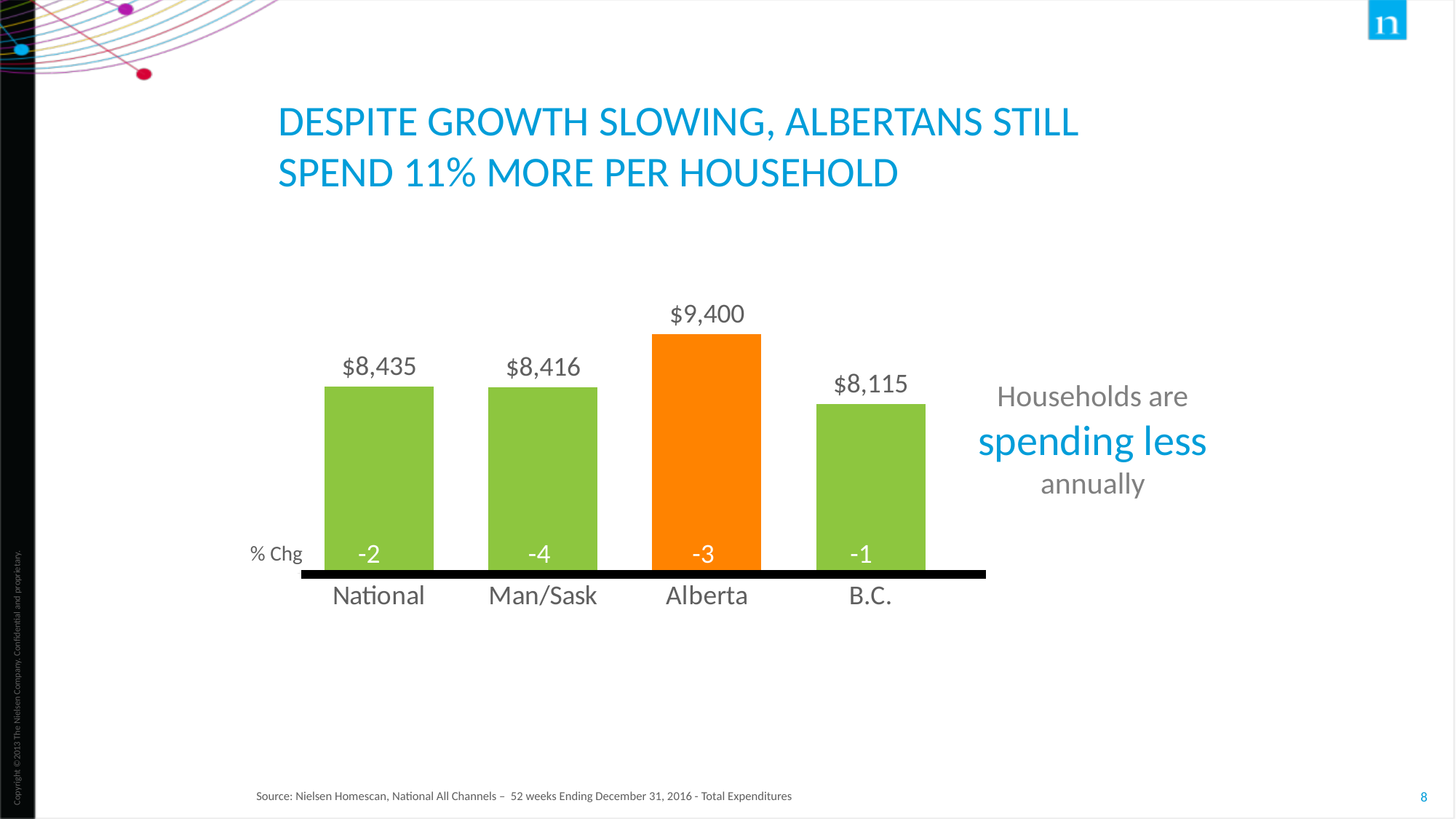
What is the value for Alberta? $9,400 Which is larger, the value for Alberta or the value for B.C.? Alberta Which category has the lowest value? B.C. What is the % Chg shown for Man/Sask? -4 What is the % Chg shown for National? -2 What is the difference between the values for Alberta and National? $965 Which category has the highest value? Alberta What is the difference between the values for National and B.C.? $320 What is the value for Man/Sask? $8,416 What is the value for B.C.? $8,115 How many categories are shown in the chart? 4 What kind of chart is shown on the slide? Bar chart